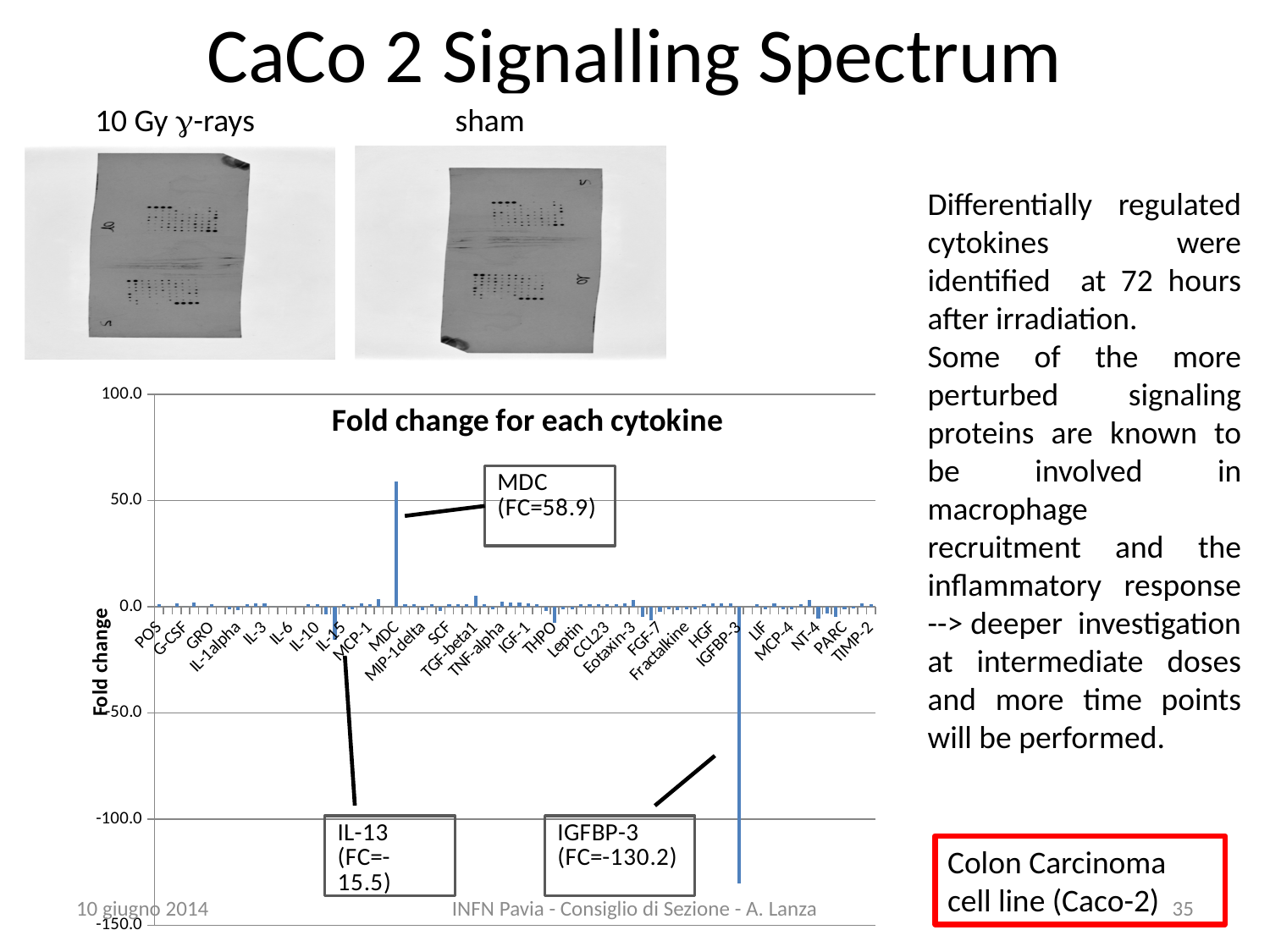
Which has the larger fold change, MDC or IL-13? MDC Is the fold change for IGFBP-3 greater or less than -100.0? less What is the fold change value for IGFBP-3? -130.2 What is the fold change value for IL-13? -15.5 Which cytokine has the lowest fold change? IGFBP-3 What is the label of the vertical axis? Fold change What kind of chart is shown on the slide? bar chart What is the title of the chart? Fold change for each cytokine What is the fold change value for MDC? 58.9 What is the difference between the fold change of MDC and that of IL-13? 74.4 What is the difference between the fold change of MDC and that of IGFBP-3? 189.1 Which cytokine has the highest fold change? MDC